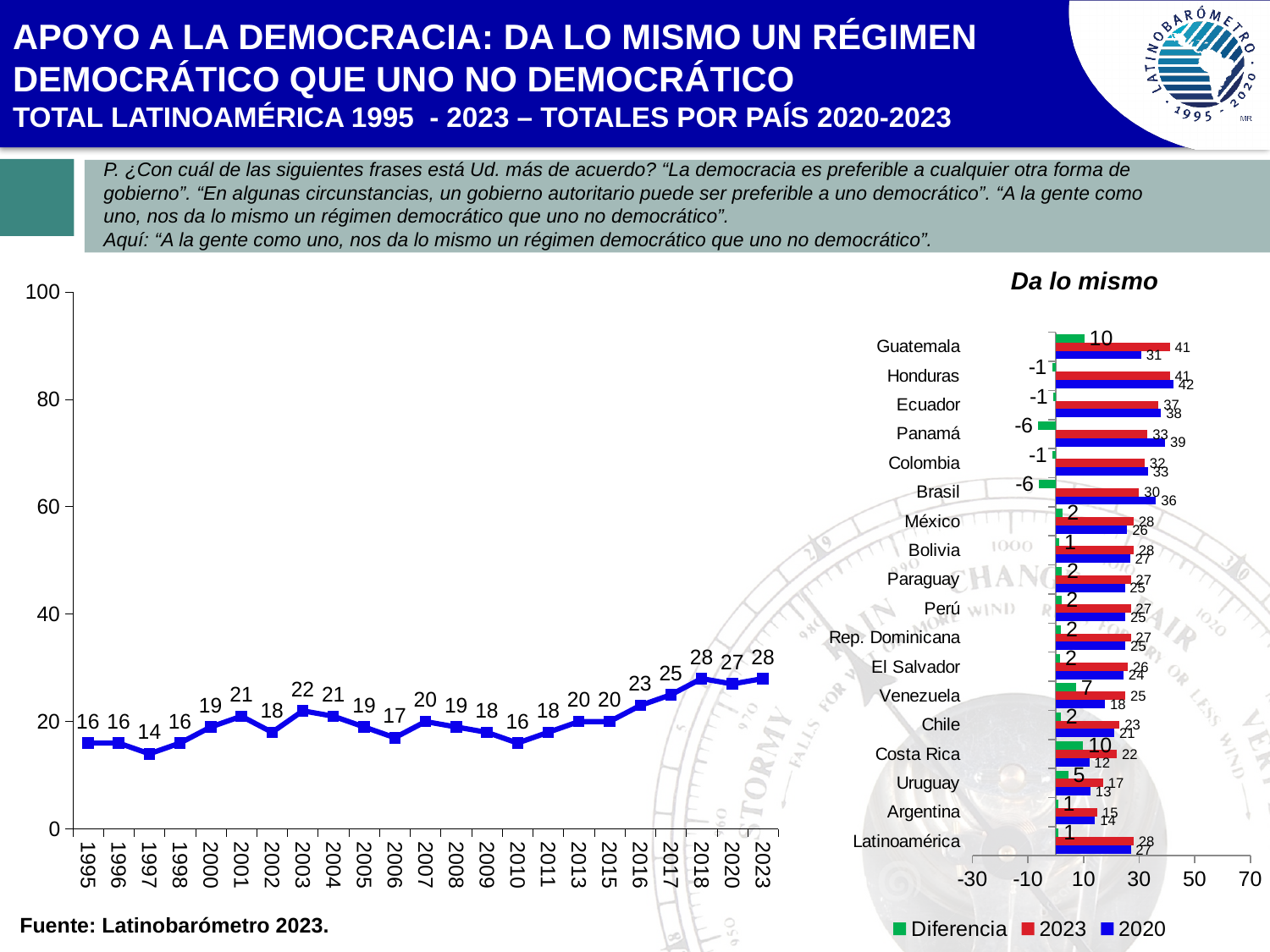
In the 'Da lo mismo' bar chart, which is larger: the 2023 value for Brasil or the 2023 value for Chile? Brasil In the line chart on the left, what is the value for 2023? 28 In the 'Da lo mismo' bar chart, how many series does the legend list? 3 In the line chart on the left, how many data points are plotted? 23 In the 'Da lo mismo' bar chart, what is the 2020 value for Venezuela? 18 In the line chart on the left, what is the difference between the values for 2017 and 2010? 9 In the 'Da lo mismo' bar chart, which country has the highest 2020 value? Honduras In the line chart on the left, which year has the lowest value? 1997 In the 'Da lo mismo' bar chart, which country has the lowest 2023 value? Argentina What kind of chart is the 'Da lo mismo' chart on the right? bar chart In the 'Da lo mismo' bar chart, what is the 2023 value for Panamá? 33 In the line chart on the left, do the values rise or fall between 2010 and 2018? rise